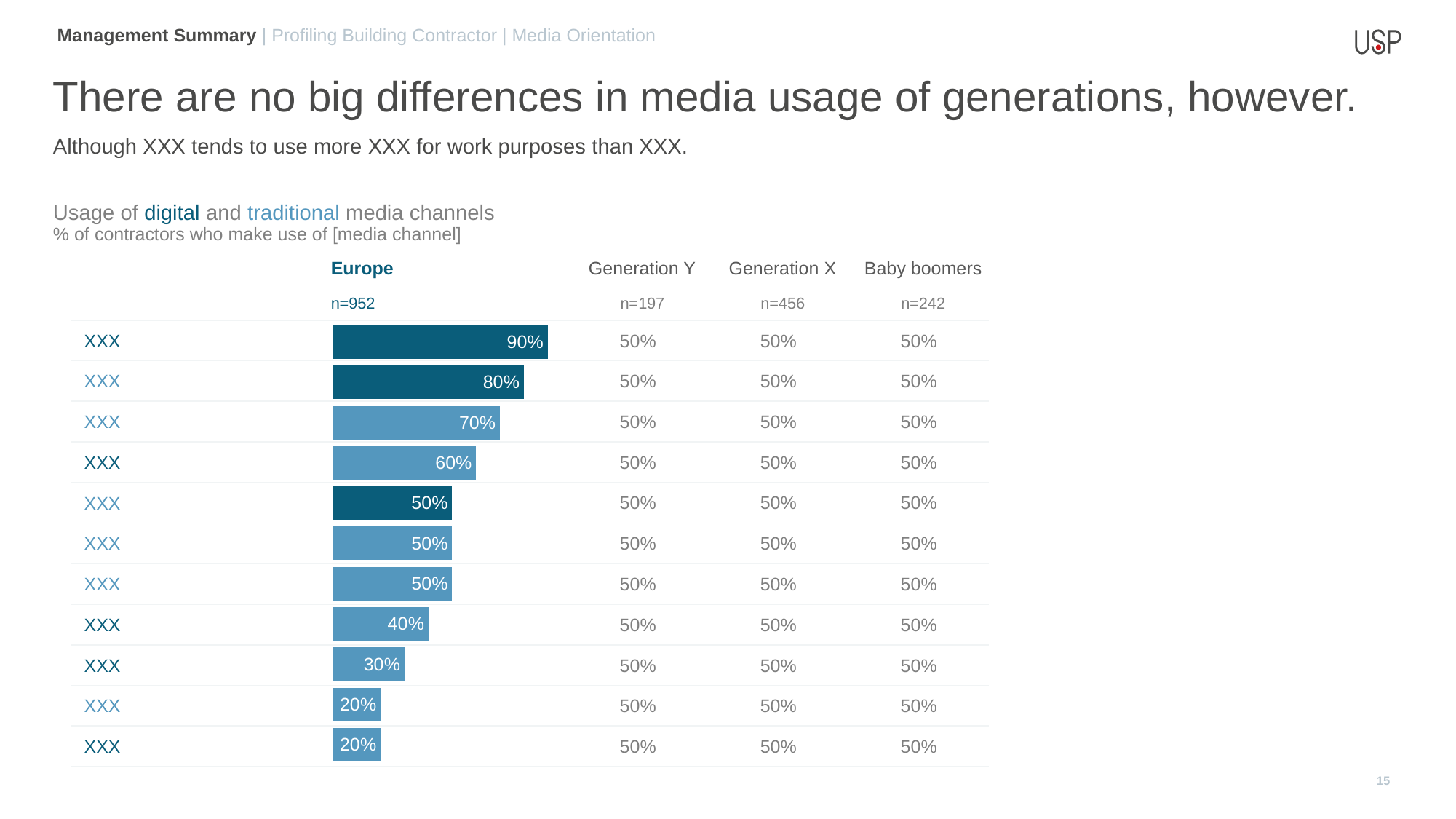
What is the difference between the highest and lowest values in the Europe bar chart? 70 percentage points Which is larger in the Europe chart: the topmost bar or the bottommost bar? The topmost bar What is the highest value shown in the Europe bar chart? 90% What kind of chart is shown on the slide? Bar chart What value is shown on the second bar from the top of the Europe chart? 80% What is the lowest value shown in the Europe bar chart? 20% How many bars are plotted in the Europe bar chart? 11 How many bars in the Europe chart show a value of 50%? 3 What value is shown on the fourth bar from the top of the Europe chart? 60% What is the sample size (n) shown for Europe? n=952 What value is shown on the topmost bar of the Europe chart? 90% Do the bar values in the Europe chart increase or decrease from top to bottom? Decrease